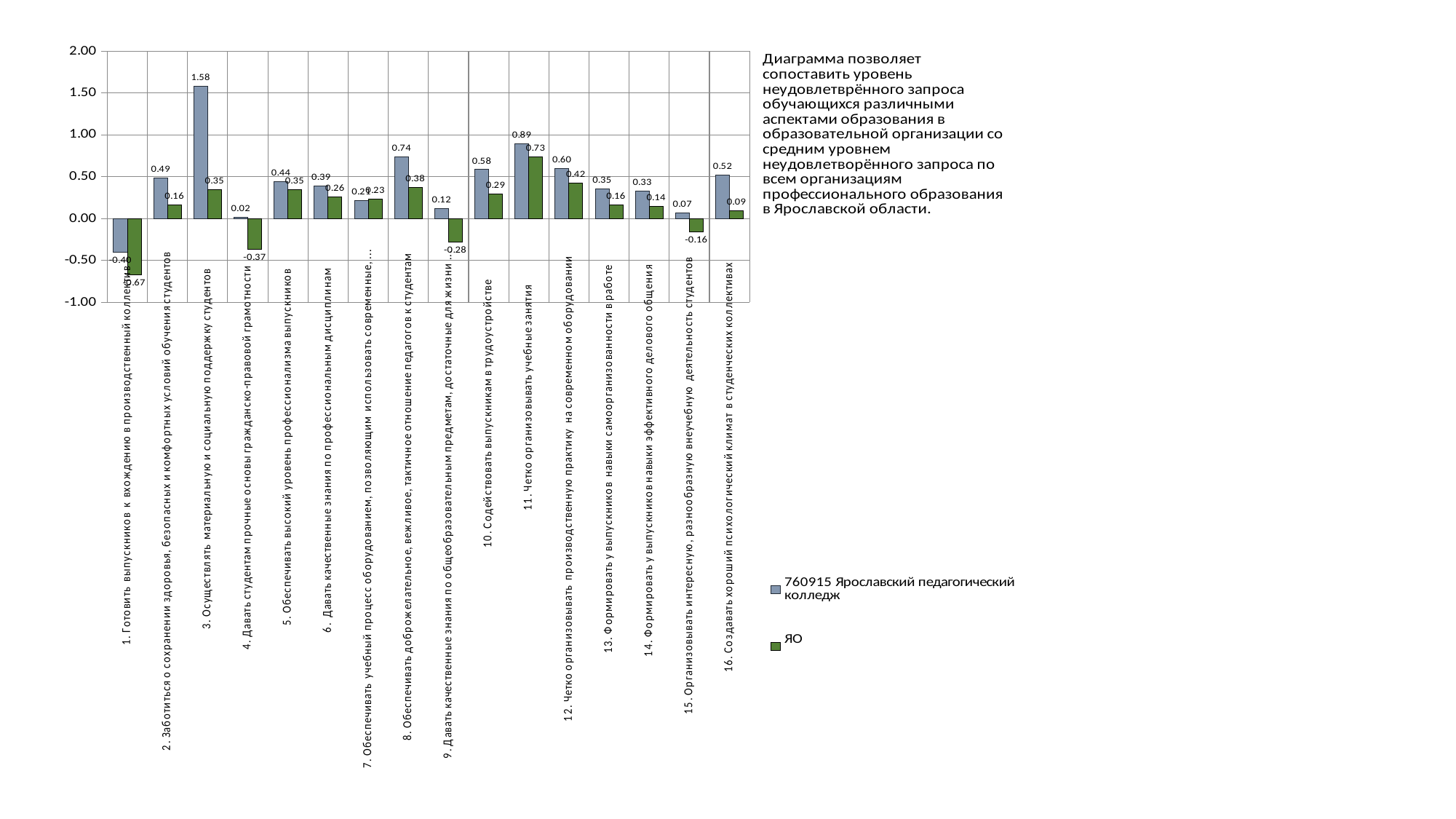
In category 16 (Создавать хороший психологический климат в студенческих коллективах), which series has the larger value: '760915 Ярославский педагогический колледж' or 'ЯО'? 760915 Ярославский педагогический колледж Which category has the highest value for the series '760915 Ярославский педагогический колледж'? 3. Осуществлять материальную и социальную поддержку студентов What is the value for the series 'ЯО' in category 4 (Давать студентам прочные основы гражданско-правовой грамотности)? -0.37 Is the value for the series '760915 Ярославский педагогический колледж' in category 3 greater or less than 1.00? greater How many categories are plotted along the x axis? 16 Which category has the lowest value for the series 'ЯО'? 1. Готовить выпускников к вхождению в производственный коллектив How many series does the legend list? 2 Which colour represents the series 'ЯО' in the chart? green What is the value for the series 'ЯО' in category 11 (Четко организовывать учебные занятия)? 0.73 What is the value for the series '760915 Ярославский педагогический колледж' in category 3 (Осуществлять материальную и социальную поддержку студентов)? 1.58 What is the difference between the '760915 Ярославский педагогический колледж' value and the 'ЯО' value in category 8 (Обеспечивать доброжелательное, вежливое, тактичное отношение педагогов к студентам)? 0.36 What type of chart is shown on the slide? bar chart